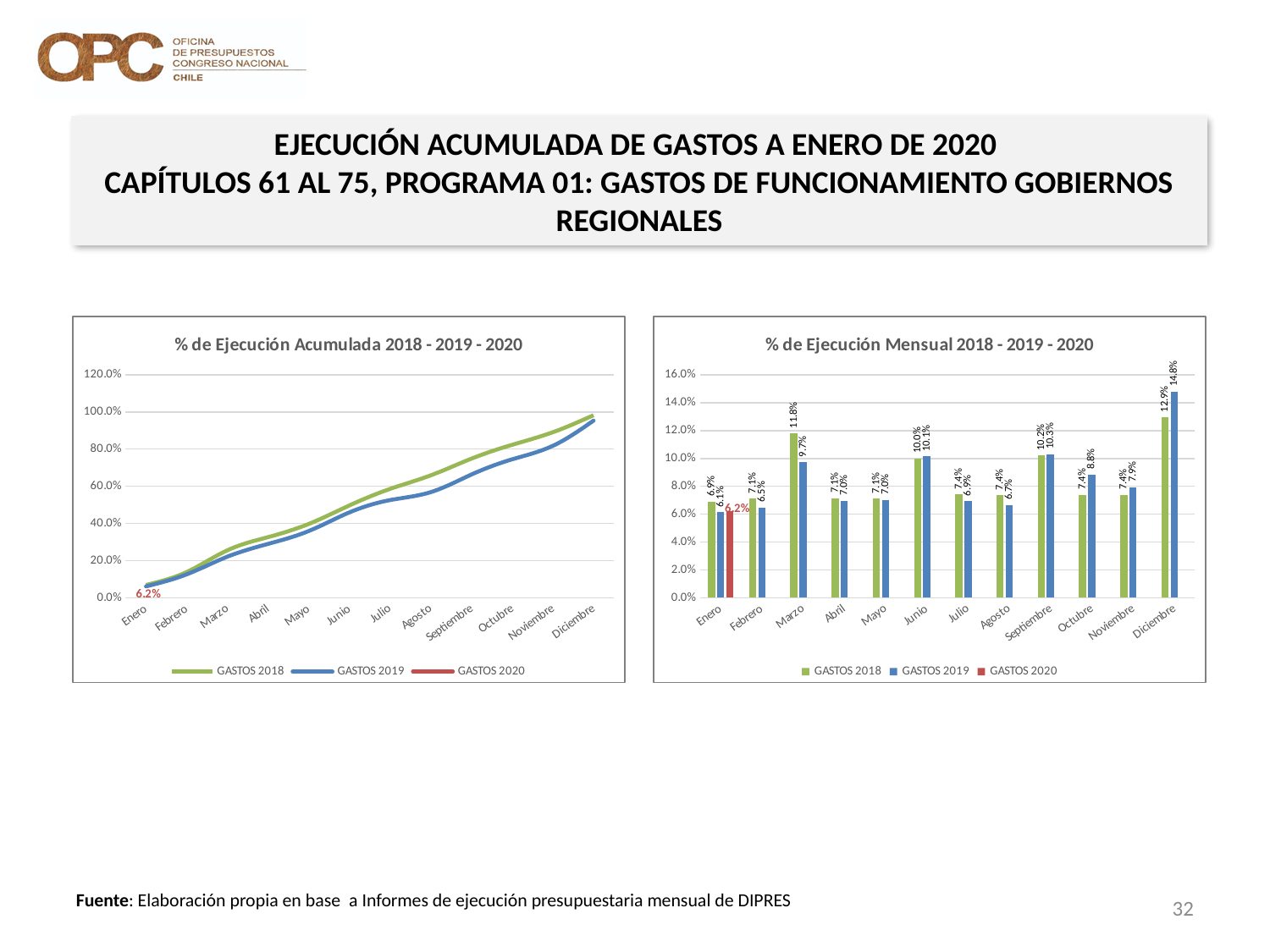
In the chart titled '% de Ejecución Mensual 2018 - 2019 - 2020', what is the difference between GASTOS 2019 and GASTOS 2018 in Diciembre? 1.9% What kind of chart is the one titled '% de Ejecución Acumulada 2018 - 2019 - 2020'? Line chart In the chart titled '% de Ejecución Mensual 2018 - 2019 - 2020', which month has the highest value for GASTOS 2018? Diciembre In the chart titled '% de Ejecución Mensual 2018 - 2019 - 2020', which month has the lowest value for GASTOS 2019? Enero In the chart titled '% de Ejecución Acumulada 2018 - 2019 - 2020', do the GASTOS 2018 and GASTOS 2019 lines rise or fall from Enero to Diciembre? Rise In the chart titled '% de Ejecución Mensual 2018 - 2019 - 2020', what is the value for GASTOS 2020 in Enero? 6.2% In the chart titled '% de Ejecución Acumulada 2018 - 2019 - 2020', is the value for GASTOS 2019 in Diciembre greater or less than 80.0%? greater In the chart titled '% de Ejecución Mensual 2018 - 2019 - 2020', how many series does the legend list? 3 In the chart titled '% de Ejecución Mensual 2018 - 2019 - 2020', which is larger in Marzo: GASTOS 2018 or GASTOS 2019? GASTOS 2018 In the chart titled '% de Ejecución Mensual 2018 - 2019 - 2020', how many months are shown on the x axis? 12 In the chart titled '% de Ejecución Mensual 2018 - 2019 - 2020', what is the value for GASTOS 2018 in Marzo? 11.8% In the chart titled '% de Ejecución Mensual 2018 - 2019 - 2020', what is the value for GASTOS 2019 in Diciembre? 14.8%